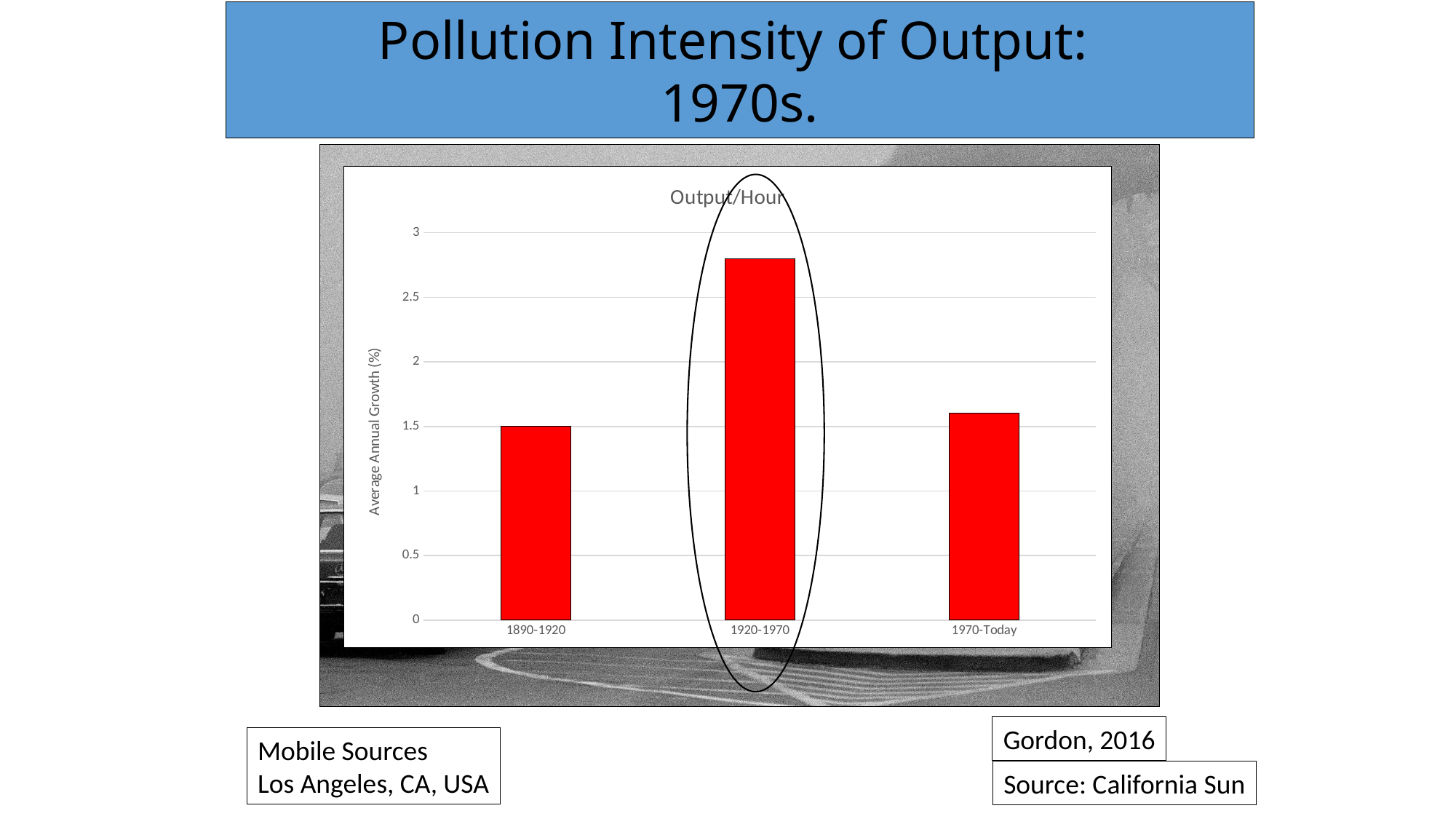
Is the value for 1890-1920 greater or less than 2? less Is the value for 1920-1970 greater or less than 2.5? greater Is the value for 1970-Today greater or less than 2? less What is the title of the chart? Output/Hour Which is larger, the value for 1920-1970 or the value for 1970-Today? 1920-1970 Which period has the highest average annual growth in output per hour? 1920-1970 How many categories (time periods) are shown on the x axis of the chart? 3 Which period has the lowest average annual growth in output per hour? 1890-1920 What kind of chart is shown on the slide? bar chart What is the label on the vertical axis of the chart? Average Annual Growth (%)